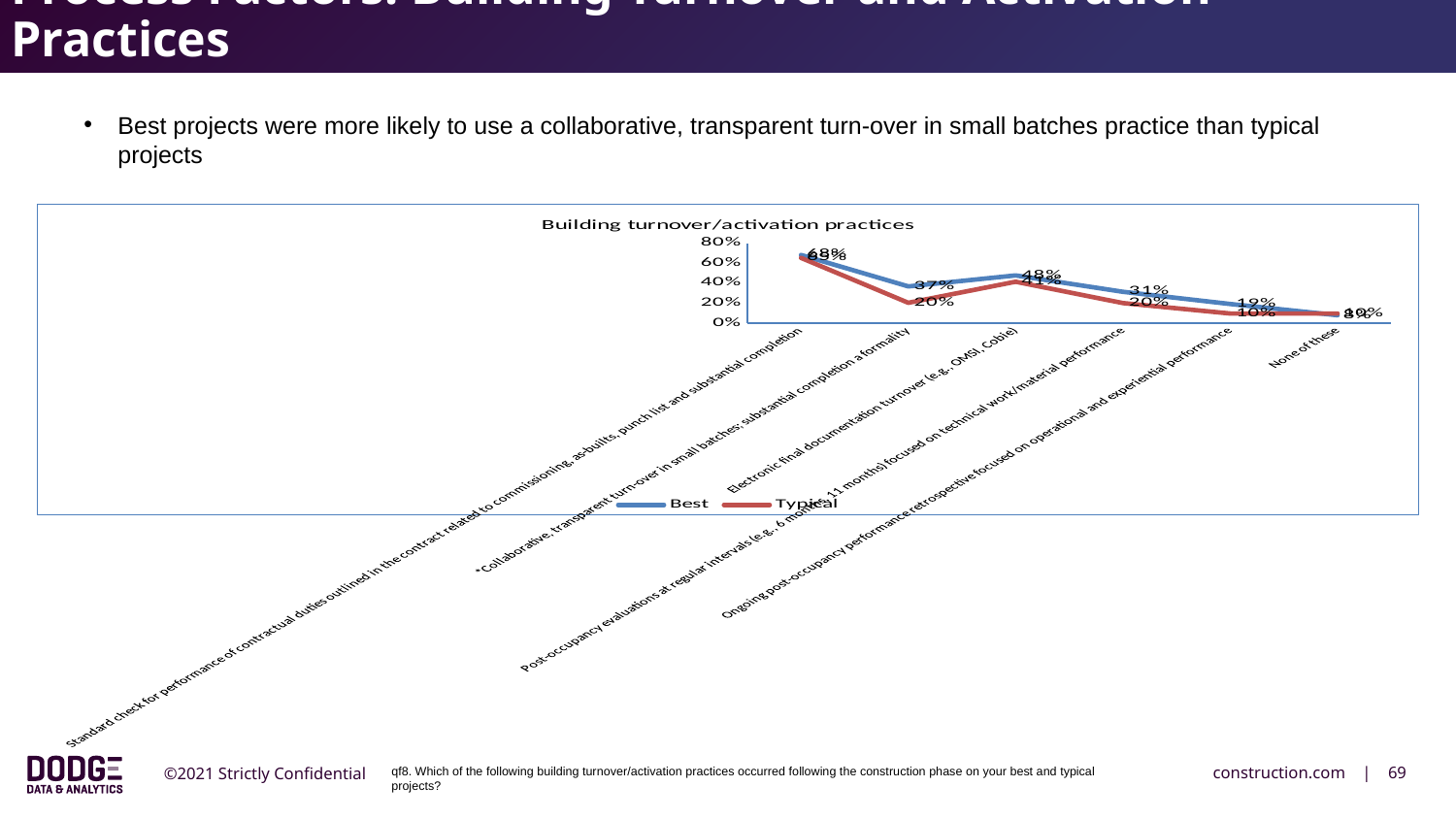
Is the Best value for 'Standard check for performance of contractual duties outlined in the contract' greater or less than 60%? greater What kind of chart is shown on the slide? line chart What is the Typical value for 'Collaborative, transparent turn-over in small batches; substantial completion a formality'? 20% What is the difference between the Best and Typical values for 'Post-occupancy evaluations at regular intervals focused on technical work/material performance'? 11 percentage points How many practice categories are plotted along the x axis of the chart? 6 Which series has the higher value for 'Ongoing post-occupancy performance retrospective focused on operational and experiential performance', Best or Typical? Best How many series does the legend of the chart list? 2 What is the Best value for 'Collaborative, transparent turn-over in small batches; substantial completion a formality'? 37% What is the Typical value for 'Electronic final documentation turnover (e.g., OMSI, Cobie)'? 41% What are the two series named in the chart legend? Best and Typical What is the Best value for 'Electronic final documentation turnover (e.g., OMSI, Cobie)'? 48% Do the Best series values generally rise or fall moving from left to right along the x axis? fall